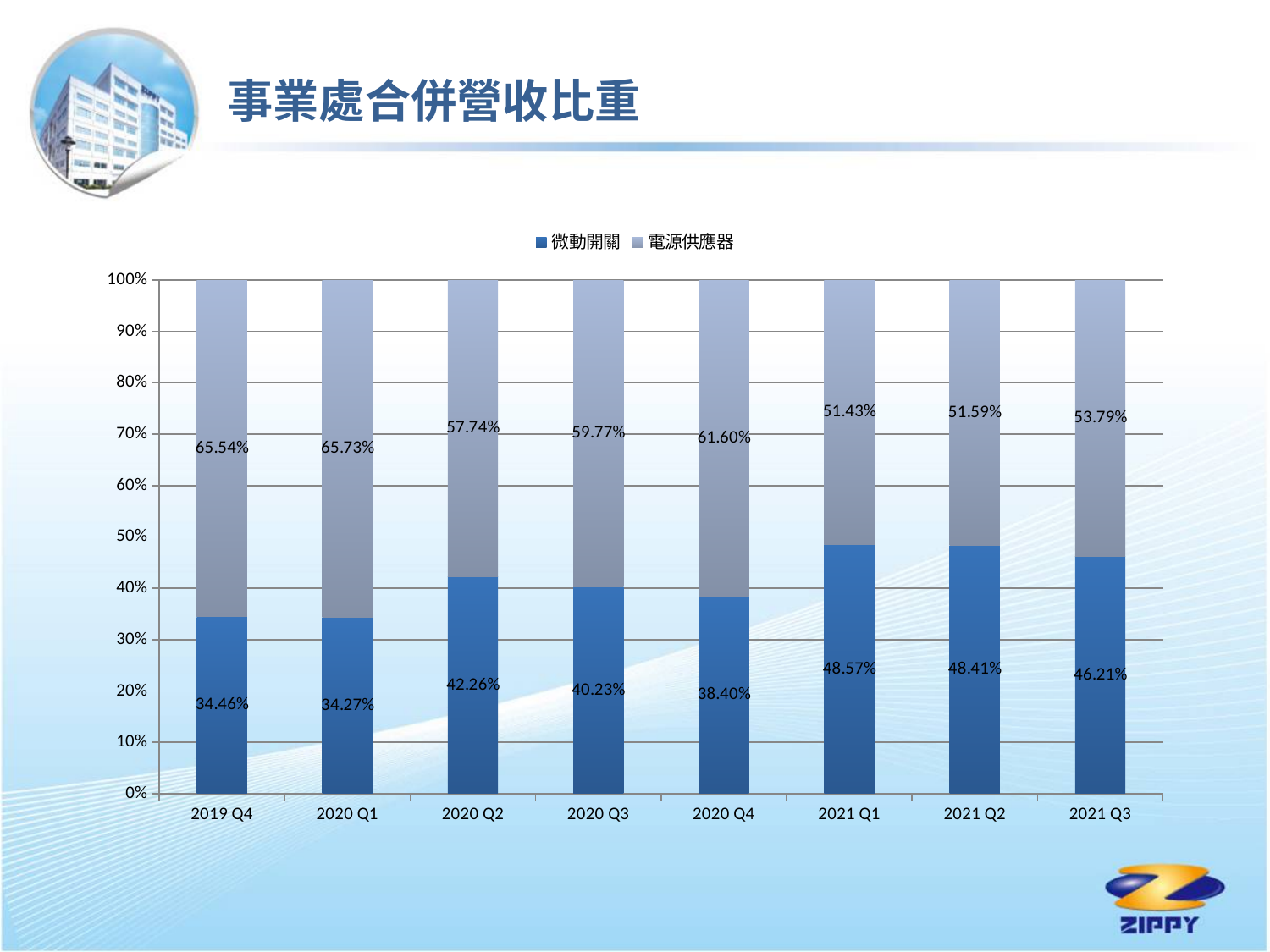
What is the value for 微動開關 in 2019 Q4? 34.46% In which quarter is the 微動開關 share highest? 2021 Q1 What kind of chart is shown on the slide? stacked bar chart Does the 微動開關 share rise or fall from 2020 Q2 to 2020 Q4? fall How many quarters are shown on the x axis? 8 What is the value for 微動開關 in 2020 Q2? 42.26% In which quarter is the 電源供應器 share lowest? 2021 Q1 What is the value for 電源供應器 in 2021 Q3? 53.79% What is the title of the slide? 事業處合併營收比重 Which is larger in 2021 Q2: the 微動開關 share or the 電源供應器 share? 電源供應器 How many series does the legend list? 2 What is the difference between the 電源供應器 share in 2020 Q4 and the 微動開關 share in 2020 Q4? 23.20%